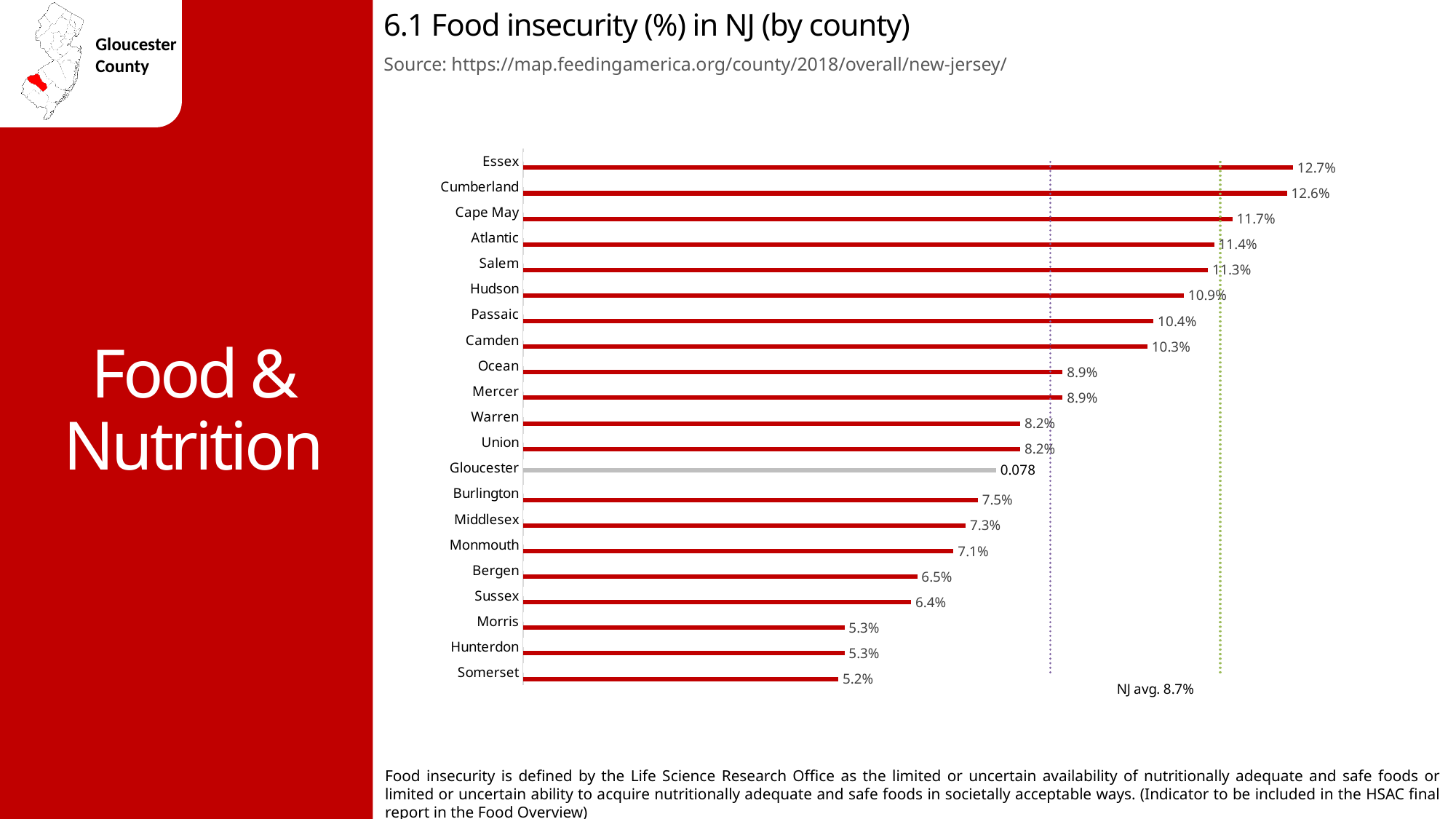
What is the food insecurity value shown for Essex county? 12.7% How many counties are plotted in the chart? 21 Which county has the highest food insecurity percentage? Essex What value is printed next to the Gloucester bar? 0.078 What is the difference in percentage points between Camden (10.3%) and Burlington (7.5%)? 2.8 Which county has a higher food insecurity percentage, Bergen or Monmouth? Monmouth What is the difference in percentage points between Essex (12.7%) and Somerset (5.2%)? 7.5 Which county has a higher food insecurity percentage, Hudson or Passaic? Hudson Which county has the lowest food insecurity percentage? Somerset What NJ average value is labeled on the chart? NJ avg. 8.7% What is the food insecurity value for Camden county? 10.3% What kind of chart is used to show food insecurity by county? Bar chart